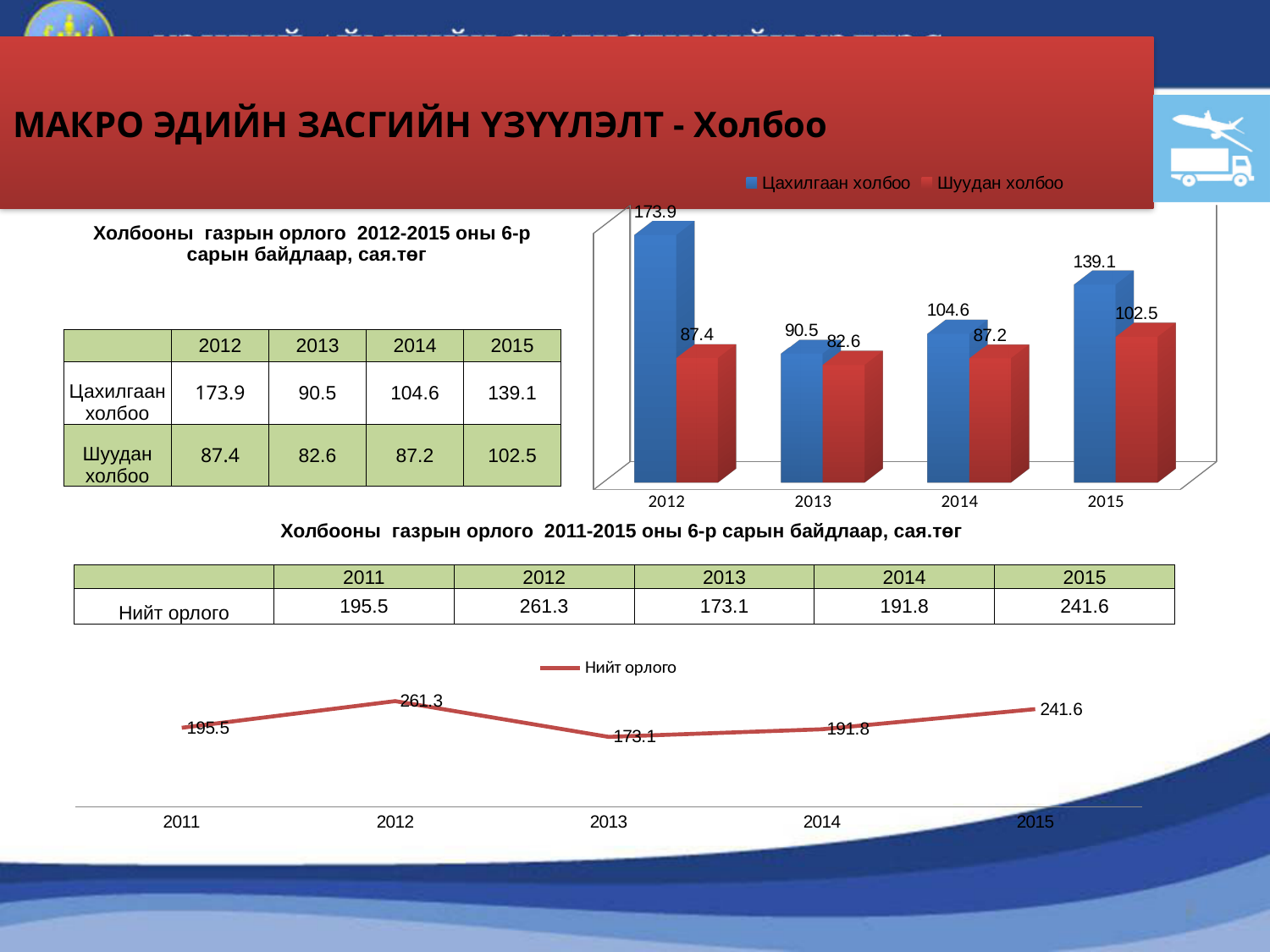
In the line chart at the bottom, does Нийт орлого rise or fall from 2013 to 2015? rise In the line chart at the bottom, which year has the lowest value of Нийт орлого? 2013 In the bar chart at the top right, what is the difference between Цахилгаан холбоо and Шуудан холбоо in 2014? 17.4 How many series does the legend of the bar chart at the top right list? 2 In the bar chart at the top right, what is the value for Шуудан холбоо in 2015? 102.5 What kind of chart is shown at the top right of the slide? bar chart In the bar chart at the top right, which year has the highest value for Цахилгаан холбоо? 2012 In the bar chart at the top right, which year has the lowest value for Шуудан холбоо? 2013 In the bar chart at the top right, which is larger in 2013: Цахилгаан холбоо or Шуудан холбоо? Цахилгаан холбоо In the line chart at the bottom, what is the value of Нийт орлого in 2012? 261.3 How many years are plotted in the line chart at the bottom? 5 In the bar chart at the top right, what is the value for Цахилгаан холбоо in 2012? 173.9